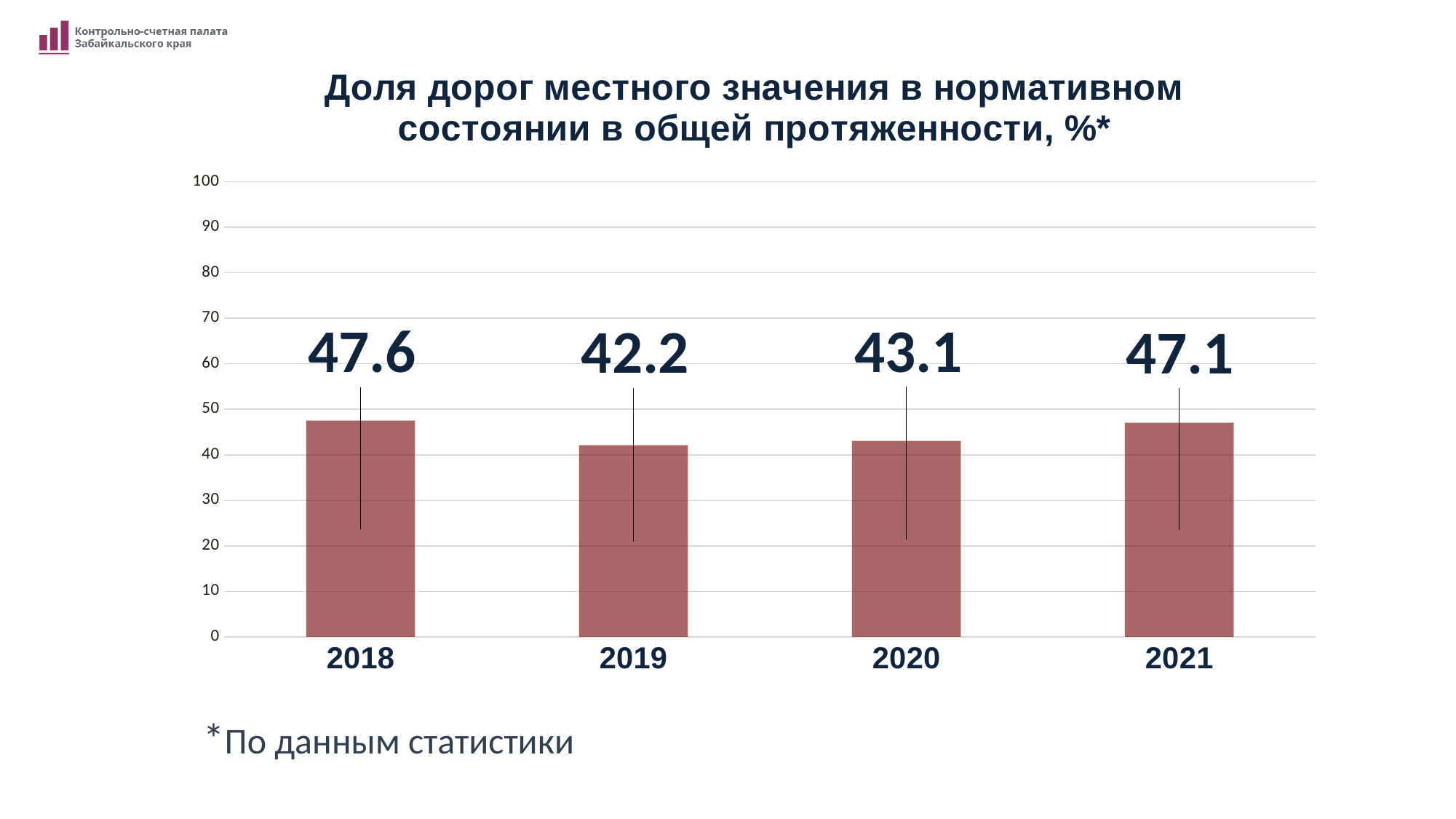
What is the value for 2018? 47.6 Is the value for 2019 greater or less than 50? less What is the value for 2021? 47.1 What is the difference between the values for 2021 and 2020? 4 Which year has the highest value? 2018 Which year has the lowest value? 2019 How many years are shown on the x axis? 4 What is the value for 2019? 42.2 What kind of chart is shown on the slide? bar chart What is the value for 2020? 43.1 Which is larger, the value for 2020 or the value for 2021? 2021 What is the difference between the values for 2018 and 2019? 5.4